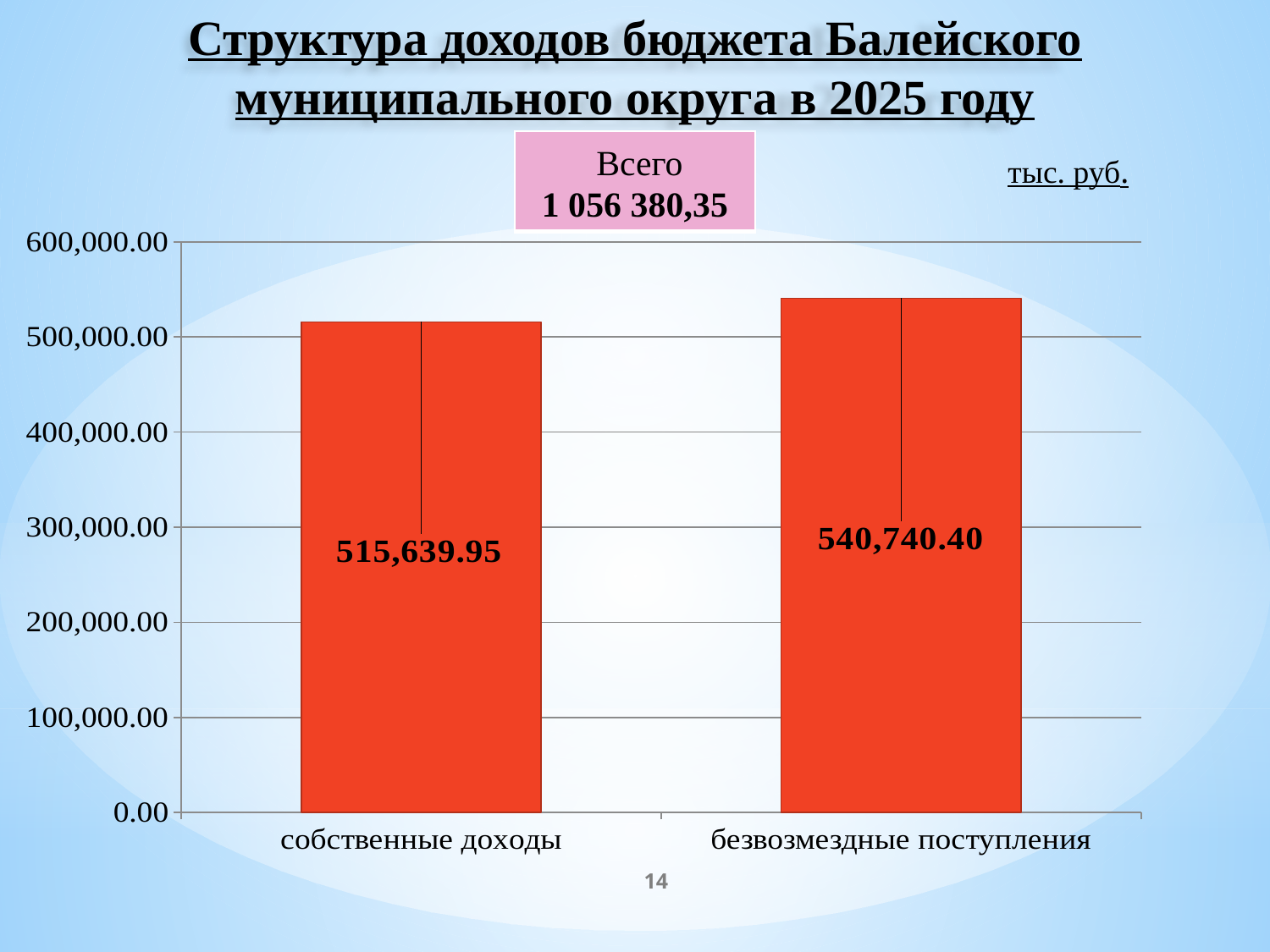
Which category has the highest value? безвозмездные поступления What unit of measurement is indicated on the slide? тыс. руб. What kind of chart is shown on the slide? bar chart What is the difference between безвозмездные поступления and собственные доходы? 25,100.45 How many categories are shown on the chart? 2 Is the value for безвозмездные поступления greater or less than 600,000.00? less What is the value for собственные доходы? 515,639.95 What is the value for безвозмездные поступления? 540,740.40 Which category has the lowest value? собственные доходы What total (Всего) is shown above the chart? 1 056 380,35 Is the value for собственные доходы greater or less than 500,000.00? greater Which is larger, собственные доходы or безвозмездные поступления? безвозмездные поступления